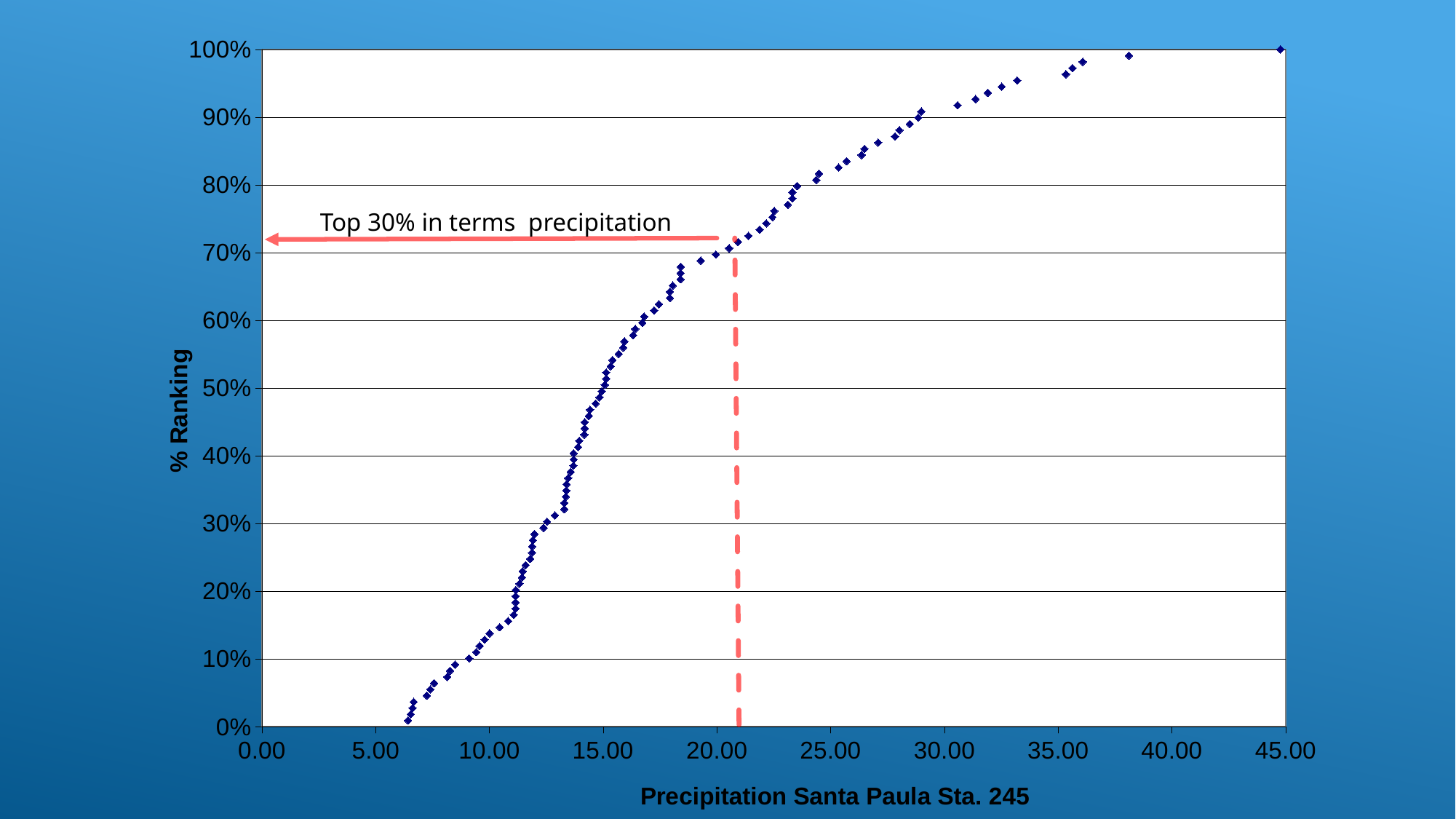
Is the precipitation value of the point at 100% ranking greater or less than 40.00? greater Which has the higher precipitation value: the point at 90% ranking or the point at 60% ranking? the point at 90% ranking Is the precipitation value of the point at 90% ranking greater or less than 25.00? greater Is the precipitation value of the point at 80% ranking greater or less than 20.00? greater Do the % Ranking values rise or fall as precipitation increases along the x axis? rise What is the title of the y axis? % Ranking What kind of chart is shown on the slide? scatter plot What is the title of the x axis? Precipitation Santa Paula Sta. 245 What % Ranking does the point with the highest precipitation value have? 100%